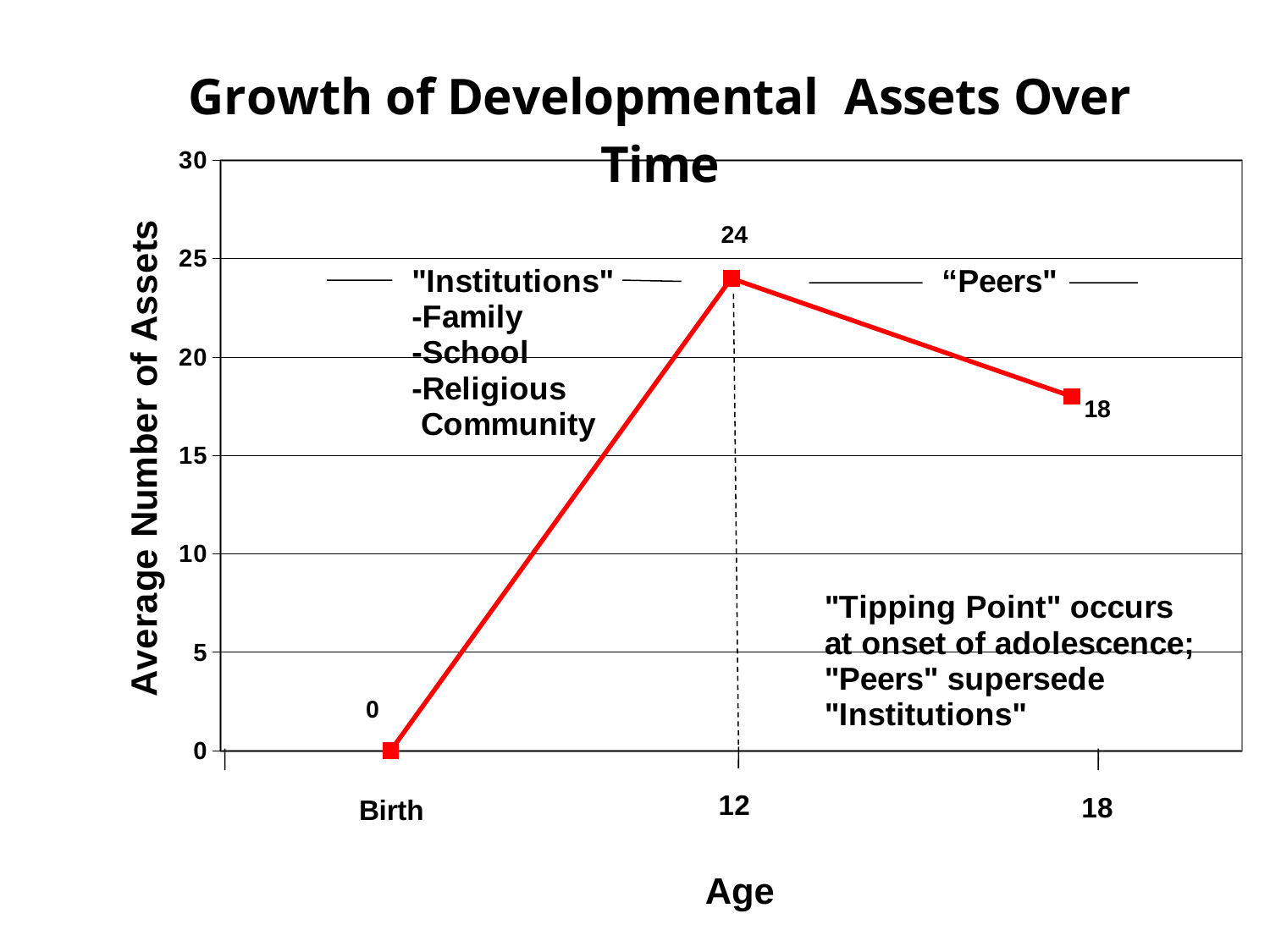
What is the average number of assets at age 18? 18 What is the average number of assets at Birth? 0 How many data points are plotted on the chart? 3 What is the average number of assets at age 12? 24 What is the label of the x axis? Age What is the difference between the average number of assets at age 12 and at age 18? 6 What is the title of the chart? Growth of Developmental Assets Over Time Does the average number of assets rise or fall between age 12 and age 18? Fall Which has a higher average number of assets, age 12 or age 18? 12 At which age is the average number of assets lowest? Birth What kind of chart is shown on the slide? Line chart At which age is the average number of assets highest? 12